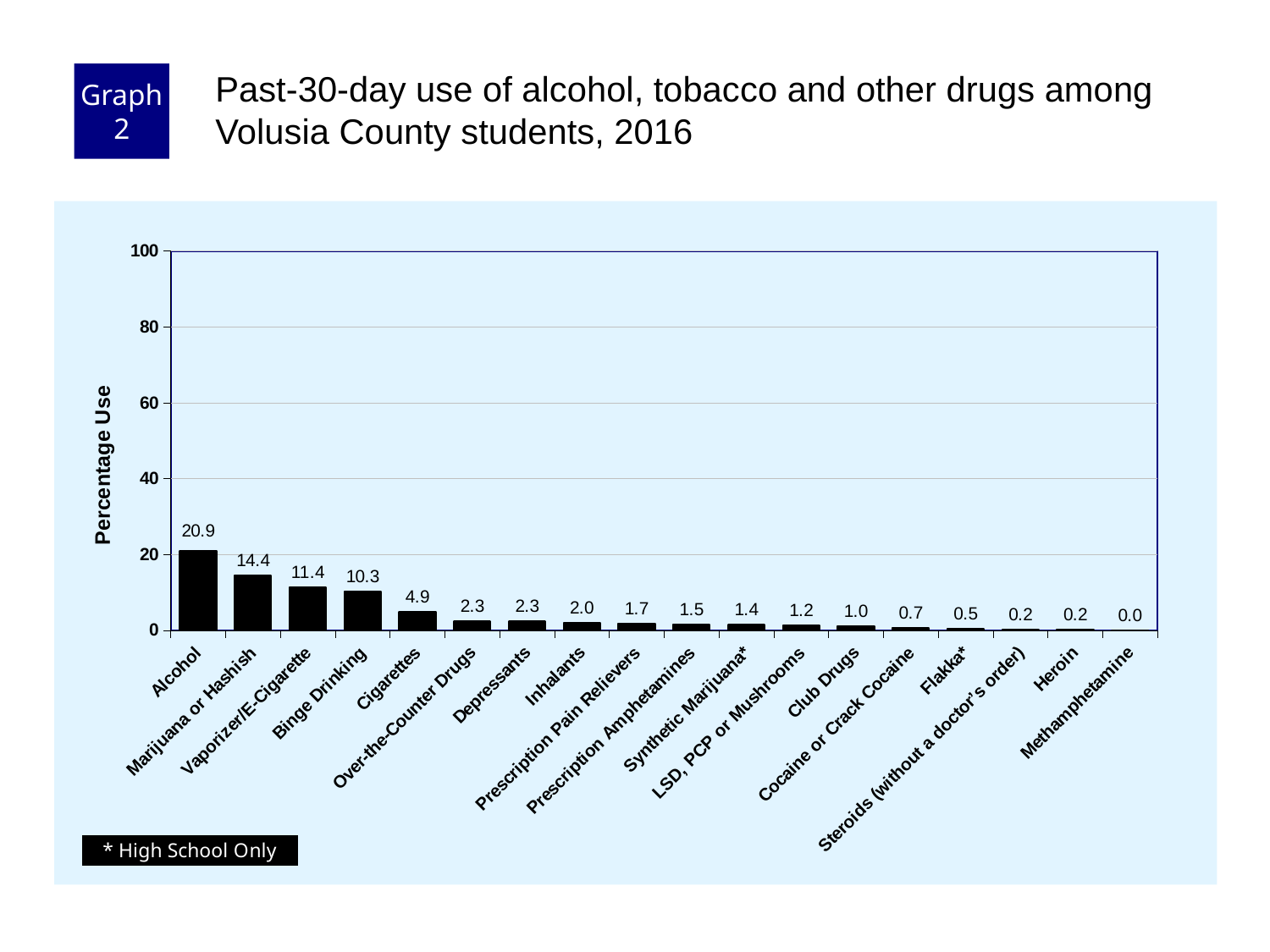
Which category has the highest percentage use? Alcohol How many categories are shown on the x axis? 18 Do the values rise or fall from left to right along the x axis? Fall What is the label of the y axis? Percentage Use What is the percentage use for Vaporizer/E-Cigarette? 11.4 What is the difference in percentage use between Alcohol and Marijuana or Hashish? 6.5 What kind of chart is shown on the slide? Bar chart Which has a higher percentage use, Binge Drinking or Cigarettes? Binge Drinking What is the percentage use for Inhalants? 2.0 What is the percentage use for Alcohol? 20.9 Which category has the lowest percentage use? Methamphetamine What is the percentage use for Cigarettes? 4.9